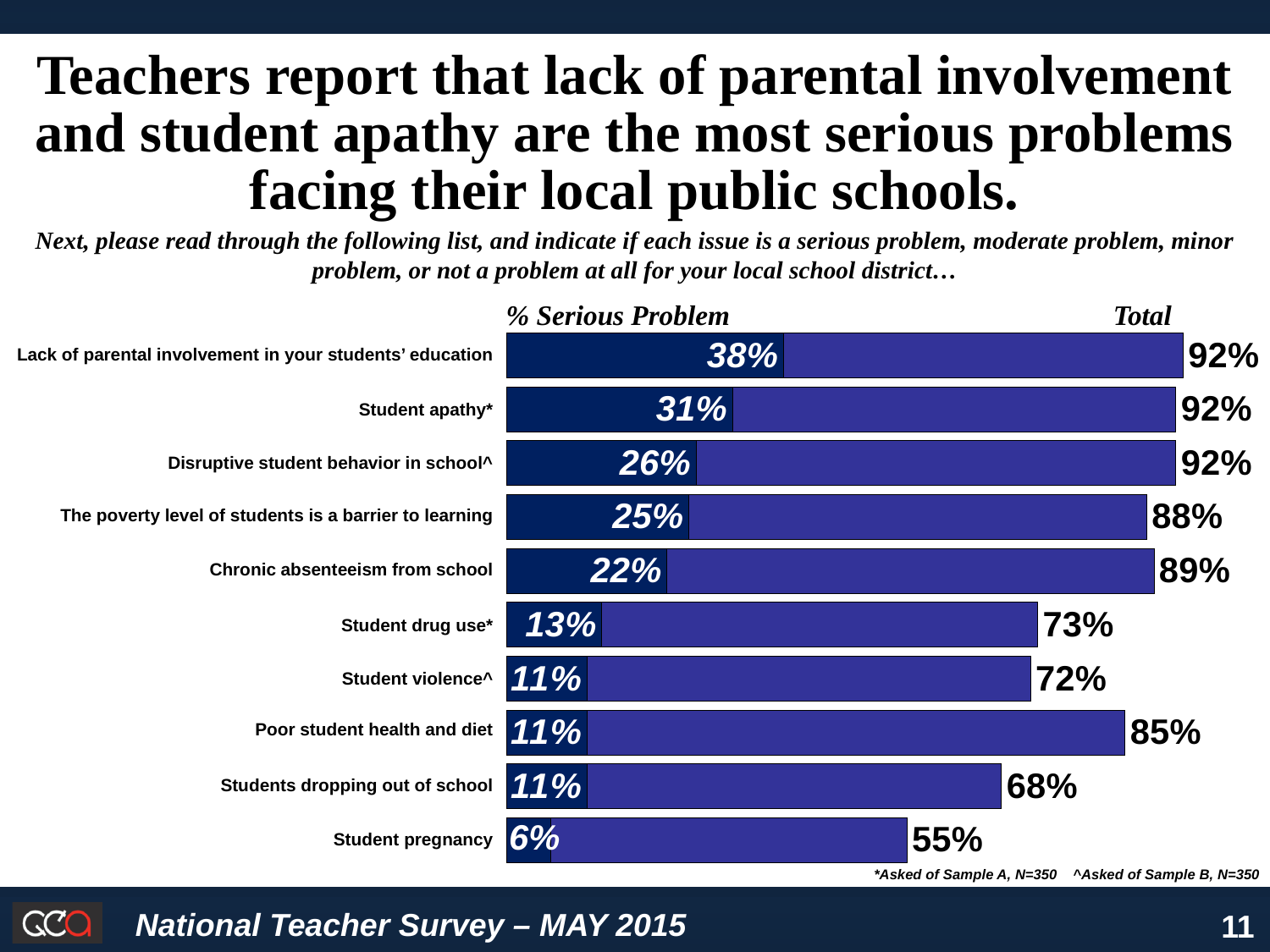
What is the difference between the % Serious Problem values for student apathy and student drug use? 18% What is the total percentage shown for student pregnancy? 55% Which issue has the highest % Serious Problem value? Lack of parental involvement in your students' education What is the difference between the total percentages for student violence and student drug use? 1% Which has a higher total percentage, poor student health and diet or students dropping out of school? Poor student health and diet Which issue has the lowest total percentage? Student pregnancy What are the two column headings shown above the chart? % Serious Problem and Total What kind of chart is shown on the slide? Bar chart What is the % Serious Problem value for chronic absenteeism from school? 22% How many issues are listed in the chart? 10 What is the total percentage for the poverty level of students is a barrier to learning? 88% What percentage of teachers rate lack of parental involvement in your students' education as a serious problem? 38%